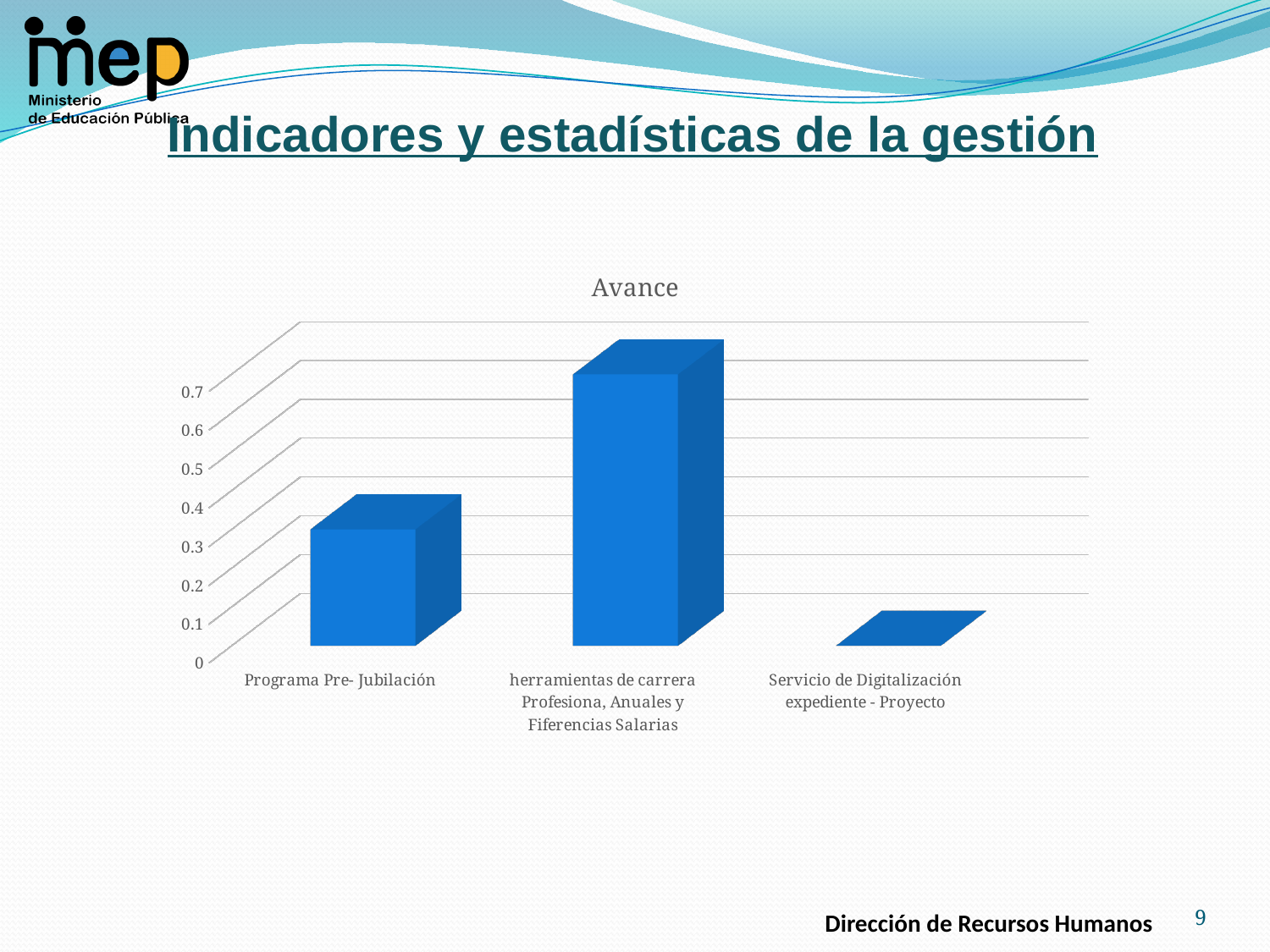
Which category has the lowest value in the chart? Servicio de Digitalización expediente - Proyecto Is the value for Servicio de Digitalización expediente - Proyecto greater or less than 0.1? less What colour are the bars in the chart? blue What is the title of the chart? Avance Is the value for Programa Pre- Jubilación greater or less than 0.1? greater What kind of chart is shown on the slide? bar chart What is the highest value labelled on the vertical axis of the chart? 0.7 Which category has the highest value in the chart? herramientas de carrera Profesiona, Anuales y Fiferencias Salarias Is the value for herramientas de carrera Profesiona, Anuales y Fiferencias Salarias greater or less than 0.5? greater Which is larger, the value for Programa Pre- Jubilación or the value for herramientas de carrera Profesiona, Anuales y Fiferencias Salarias? herramientas de carrera Profesiona, Anuales y Fiferencias Salarias How many categories are plotted in the chart? 3